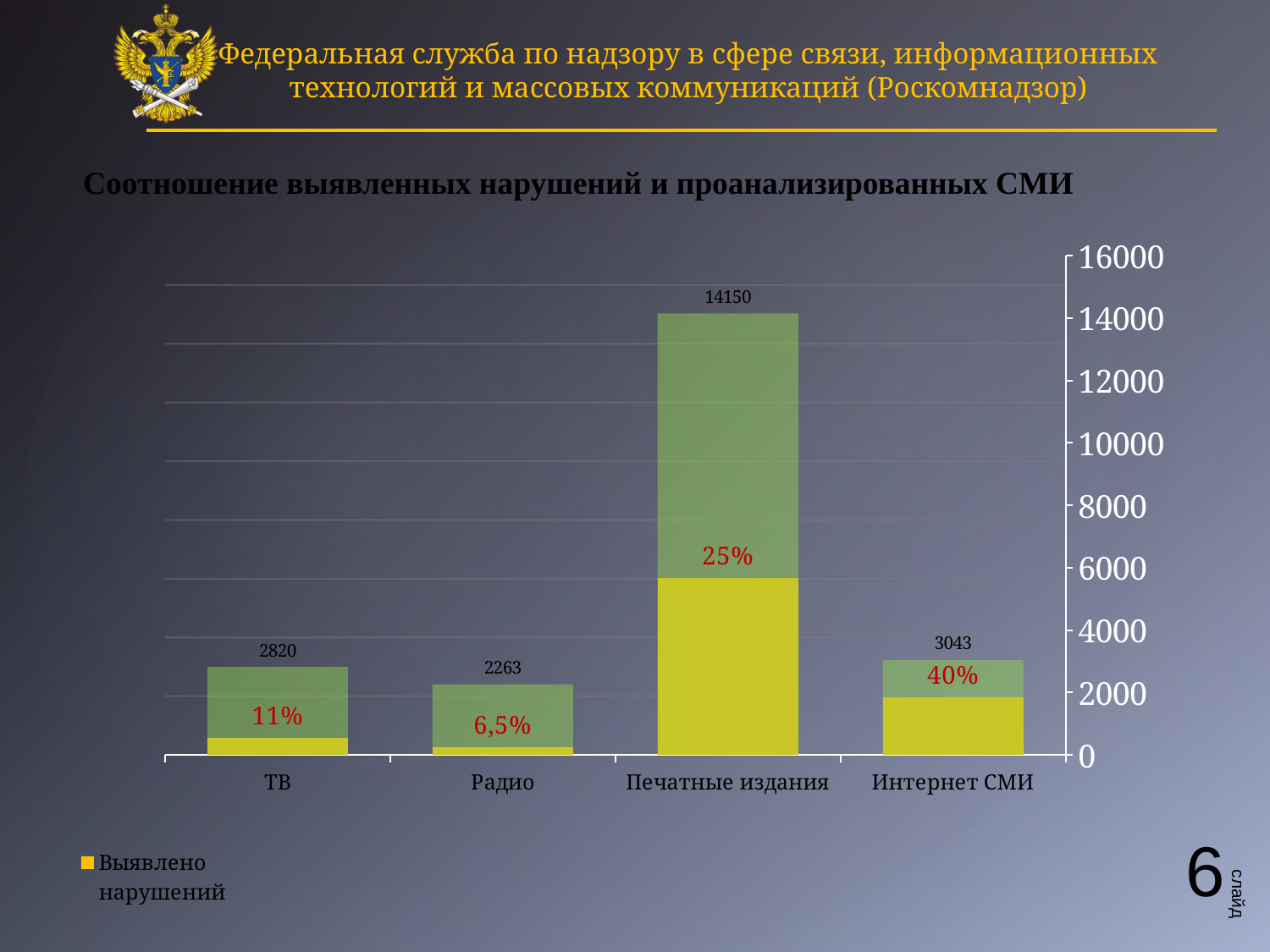
Which is larger, the value for ТВ or the value for Интернет СМИ? Интернет СМИ What percentage label is shown on the Интернет СМИ bar? 40% What kind of chart is shown on the slide? bar chart Which category has the highest value? Печатные издания What is the value shown for Радио? 2263 Which category has the lowest value? Радио What is the value shown for Печатные издания? 14150 What is the difference between the values for Печатные издания and Интернет СМИ? 11107 How many categories are shown on the x axis? 4 What is the value shown for ТВ? 2820 What percentage label is shown on the Радио bar? 6,5%